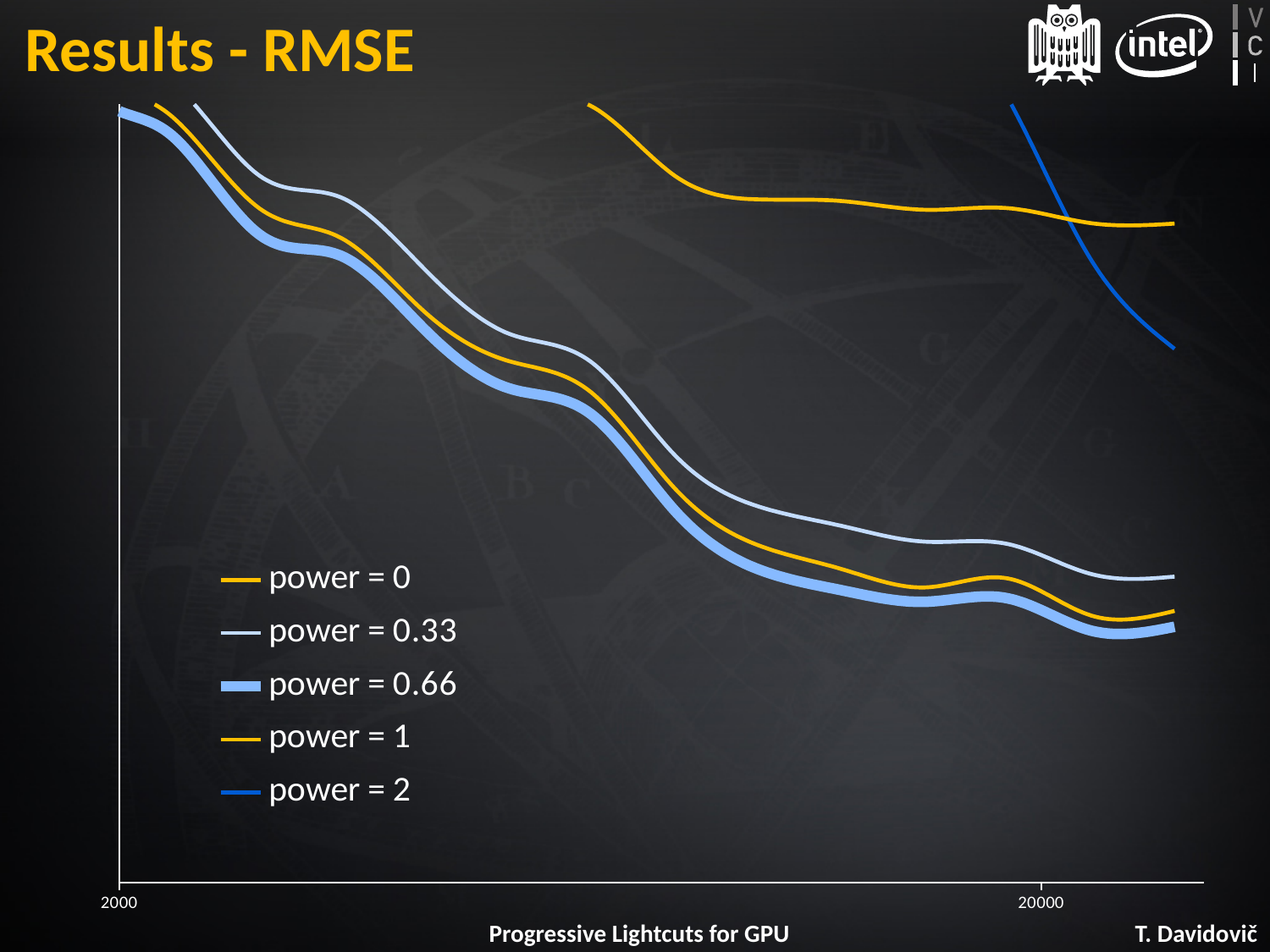
At the right end of the chart, which of the five series has the lowest line? power = 0.66 What kind of chart is shown on the slide? line chart Does the power = 0.33 line rise or fall as you move along the x axis? fall At the right end of the chart, which line is higher: power = 0.33 or power = 0.66? power = 0.33 At the right end of the chart, which line is higher: power = 2 or power = 0.66? power = 2 Does the power = 0.66 line rise or fall as you move along the x axis? fall What are the series names listed in the legend? power = 0, power = 0.33, power = 0.66, power = 1, power = 2 How many series does the legend list? 5 What are the two tick labels shown on the x axis? 2000 and 20000 Does the power = 2 line rise or fall as you move along the x axis? fall